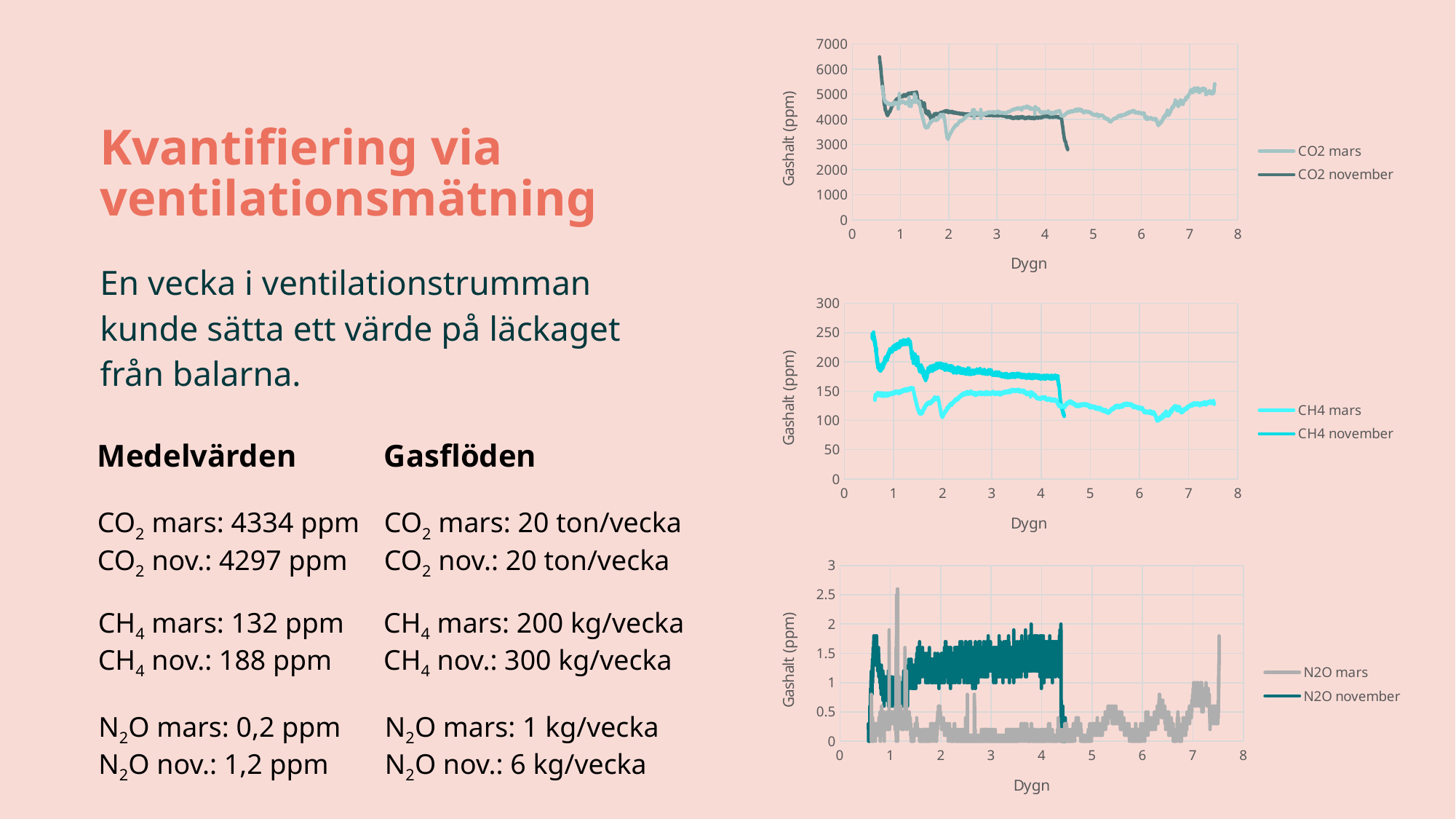
In the bottom chart (N2O), which series has the higher value at day 3, N2O mars or N2O november? N2O november What is the x-axis title of the bottom chart (N2O)? Dygn In the middle chart (CH4), which series has the higher value at day 3, CH4 mars or CH4 november? CH4 november What are the legend entries of the middle chart (CH4)? CH4 mars, CH4 november In the bottom chart (N2O), is the value of N2O november at day 3 greater or less than 1? greater What kind of chart is the top chart (CO2)? line chart How many charts are shown on the slide? 3 How many series does the legend of the top chart (CO2) list? 2 In the top chart (CO2), is the value of CO2 mars at day 7.5 greater or less than 5000? greater In the middle chart (CH4), is the value of CH4 november at day 3 greater or less than 150? greater In the middle chart (CH4), does the CH4 november series rise or fall from day 1 to day 4? fall